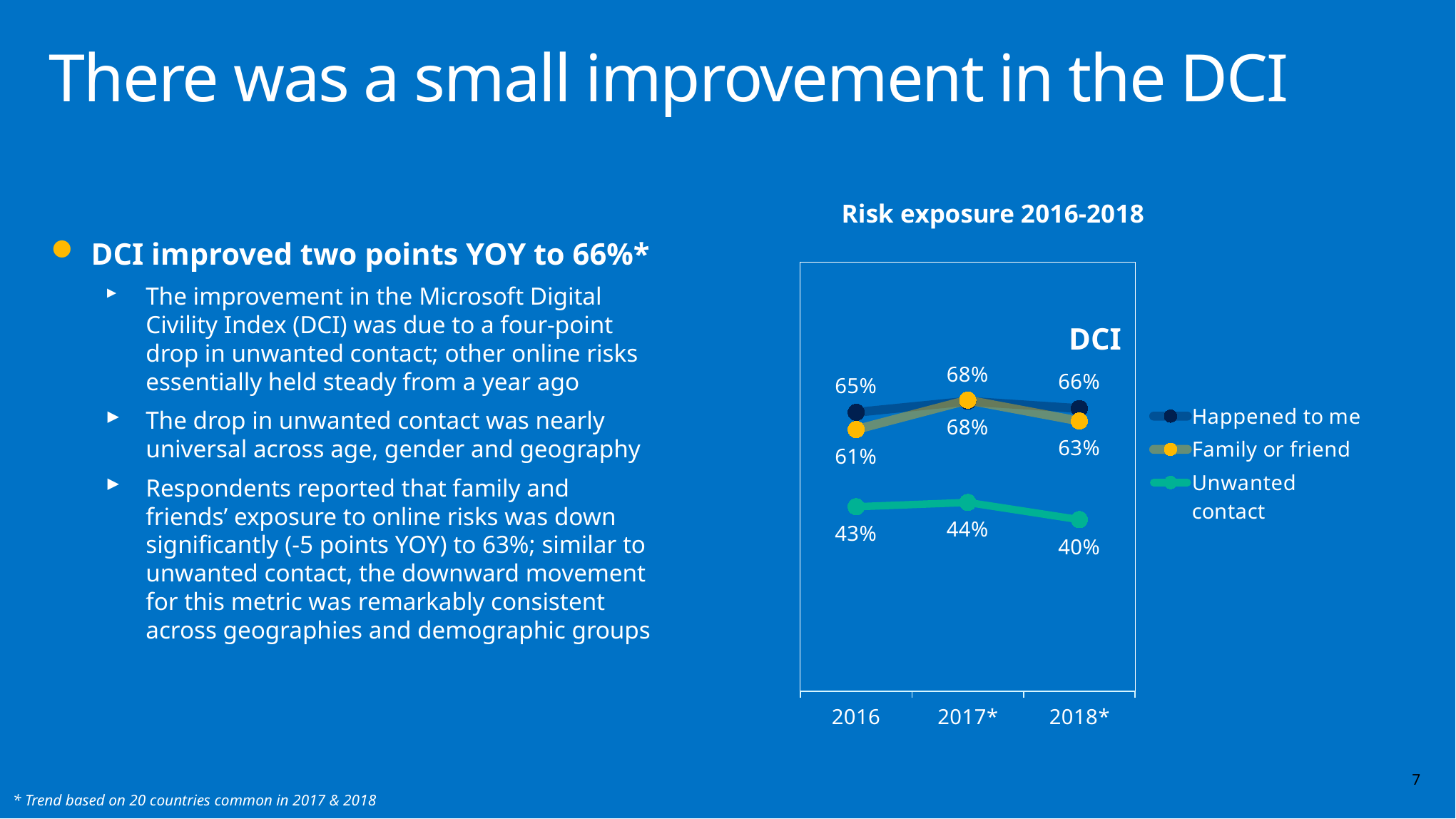
What is the value for Unwanted contact in 2017*? 44% How many years are shown on the x axis of the chart? 3 What is the difference between the Unwanted contact values for 2017* and 2018*? 4% In which year is the Unwanted contact value lowest? 2018* In which year is the Happened to me value highest? 2017* What is the value for Family or friend in 2016? 61% What type of chart is shown on the slide? Line chart Which is larger in 2018*: Happened to me or Family or friend? Happened to me How many series does the chart legend list? 3 What is the value for Happened to me in 2018*? 66% What is the title of the chart? Risk exposure 2016-2018 Does the Family or friend series rise or fall from 2017* to 2018*? Fall